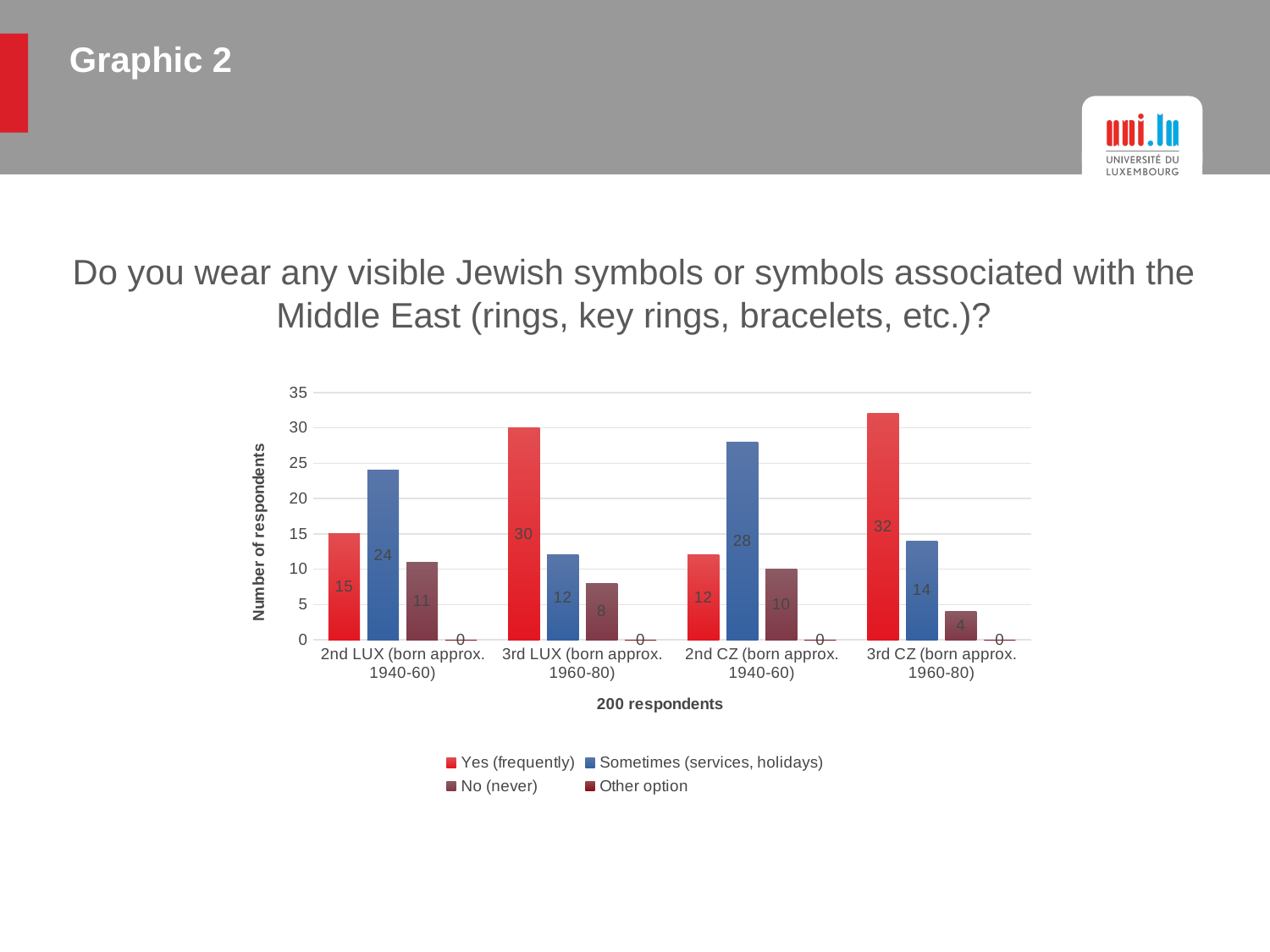
What is the label of the y axis? Number of respondents How many groups are shown on the x axis? 4 Is the value for "Yes (frequently)" in the 3rd LUX (born approx. 1960-80) group greater or less than 25? greater What kind of chart is shown on the slide? Bar chart How many series does the legend list? 4 Which is larger: "Yes (frequently)" for 2nd LUX (born approx. 1940-60) or "Yes (frequently)" for 2nd CZ (born approx. 1940-60)? 2nd LUX (born approx. 1940-60) Which group has the lowest value for "No (never)"? 3rd CZ (born approx. 1960-80) What is the difference between the "Sometimes (services, holidays)" values for 2nd CZ (born approx. 1940-60) and 3rd CZ (born approx. 1960-80)? 14 What is the value for "Yes (frequently)" in the 3rd CZ (born approx. 1960-80) group? 32 What is the value for "No (never)" in the 3rd LUX (born approx. 1960-80) group? 8 What is the value for "Sometimes (services, holidays)" in the 2nd LUX (born approx. 1940-60) group? 24 Which group has the highest value for "Yes (frequently)"? 3rd CZ (born approx. 1960-80)